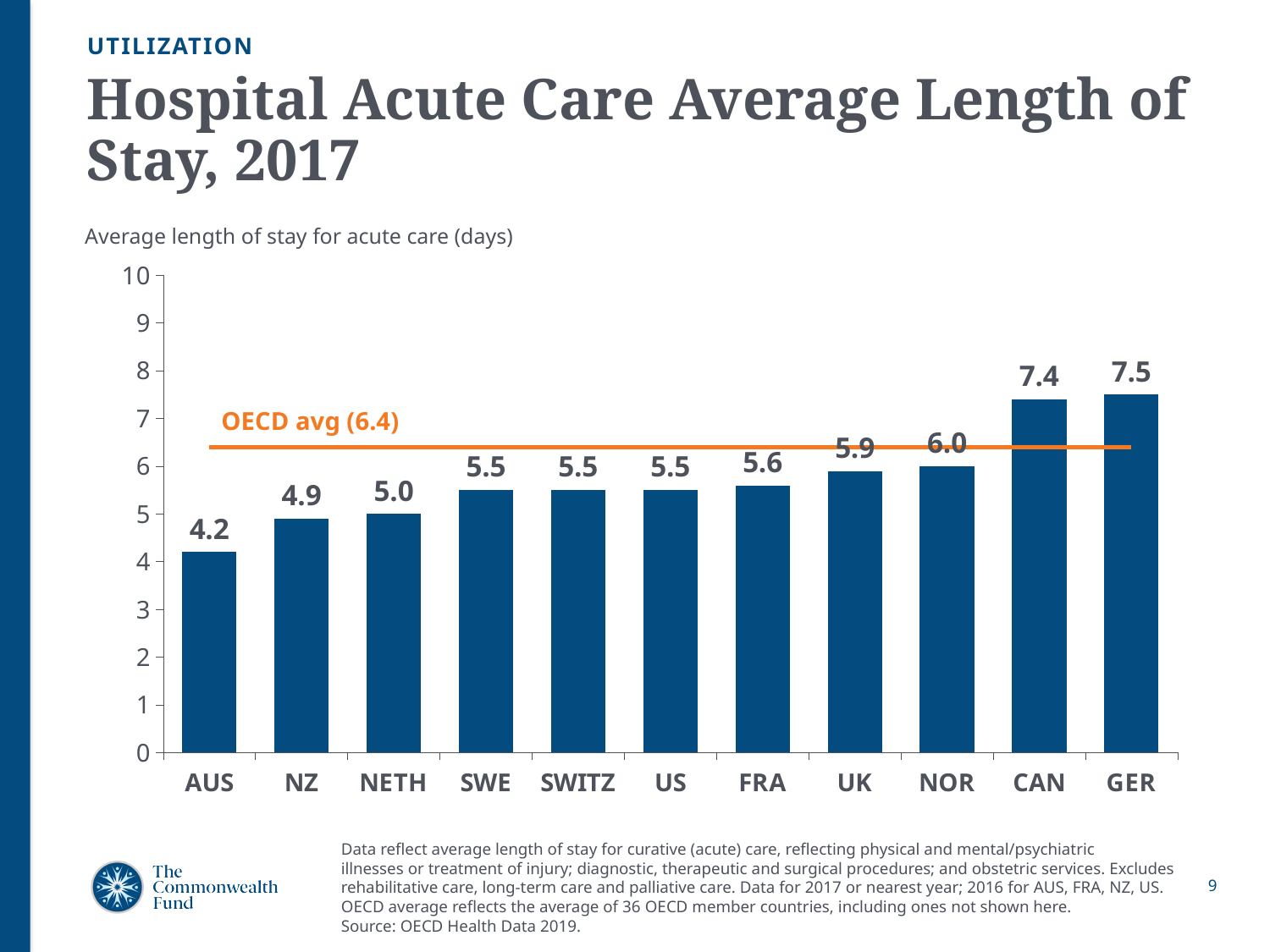
What is the OECD average length of stay shown by the orange line? 6.4 Which country has the lowest average length of stay for acute care? AUS What kind of chart is shown on the slide? Bar chart What is the average length of stay for acute care in the US? 5.5 How many countries are shown in the chart? 11 Is the value for Canada (CAN) greater or less than 7? greater What is the average length of stay for acute care in Germany (GER)? 7.5 What is the difference in average length of stay between Germany (GER) and Australia (AUS)? 3.3 What is the difference in average length of stay between Canada (CAN) and the UK? 1.5 Which country has the highest average length of stay for acute care? GER Which has a longer average length of stay, France (FRA) or New Zealand (NZ)? FRA What is the average length of stay for acute care in Norway (NOR)? 6.0